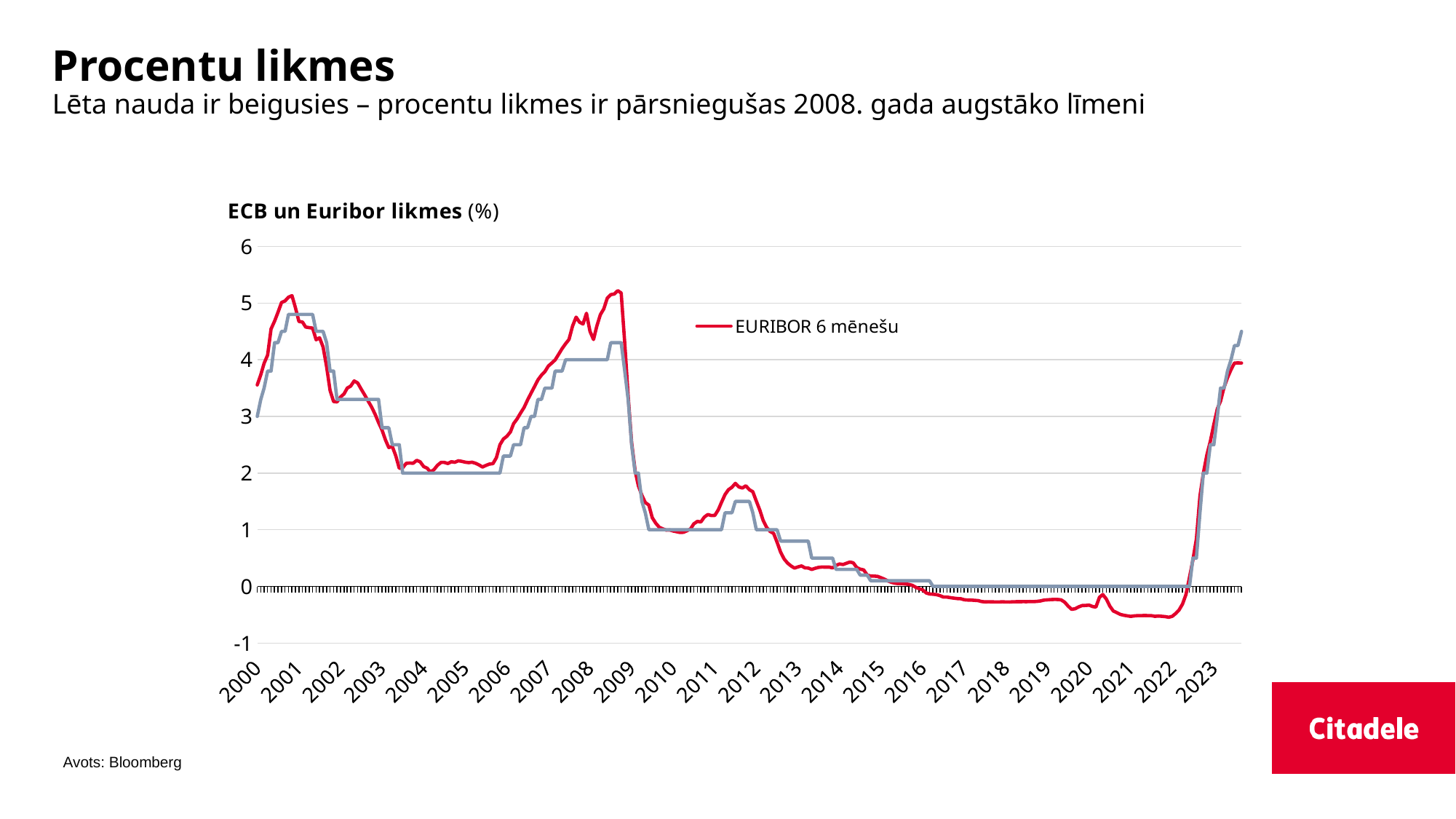
How many year labels are shown on the x axis? 24 What kind of chart is shown on the slide? line chart Is the value of EURIBOR 6 mēnešu at the start of 2001 greater or less than 4? greater How many series does the chart legend list? 1 Is the value of EURIBOR 6 mēnešu in 2021 greater or less than 0? less Does the EURIBOR 6 mēnešu line rise or fall between 2022 and 2023? rise What is the title of the chart? ECB un Euribor likmes (%) Is the value of EURIBOR 6 mēnešu at its 2008 peak greater or less than 5? greater Does the EURIBOR 6 mēnešu line rise or fall between 2008 and 2009? fall Which series is named in the chart legend? EURIBOR 6 mēnešu